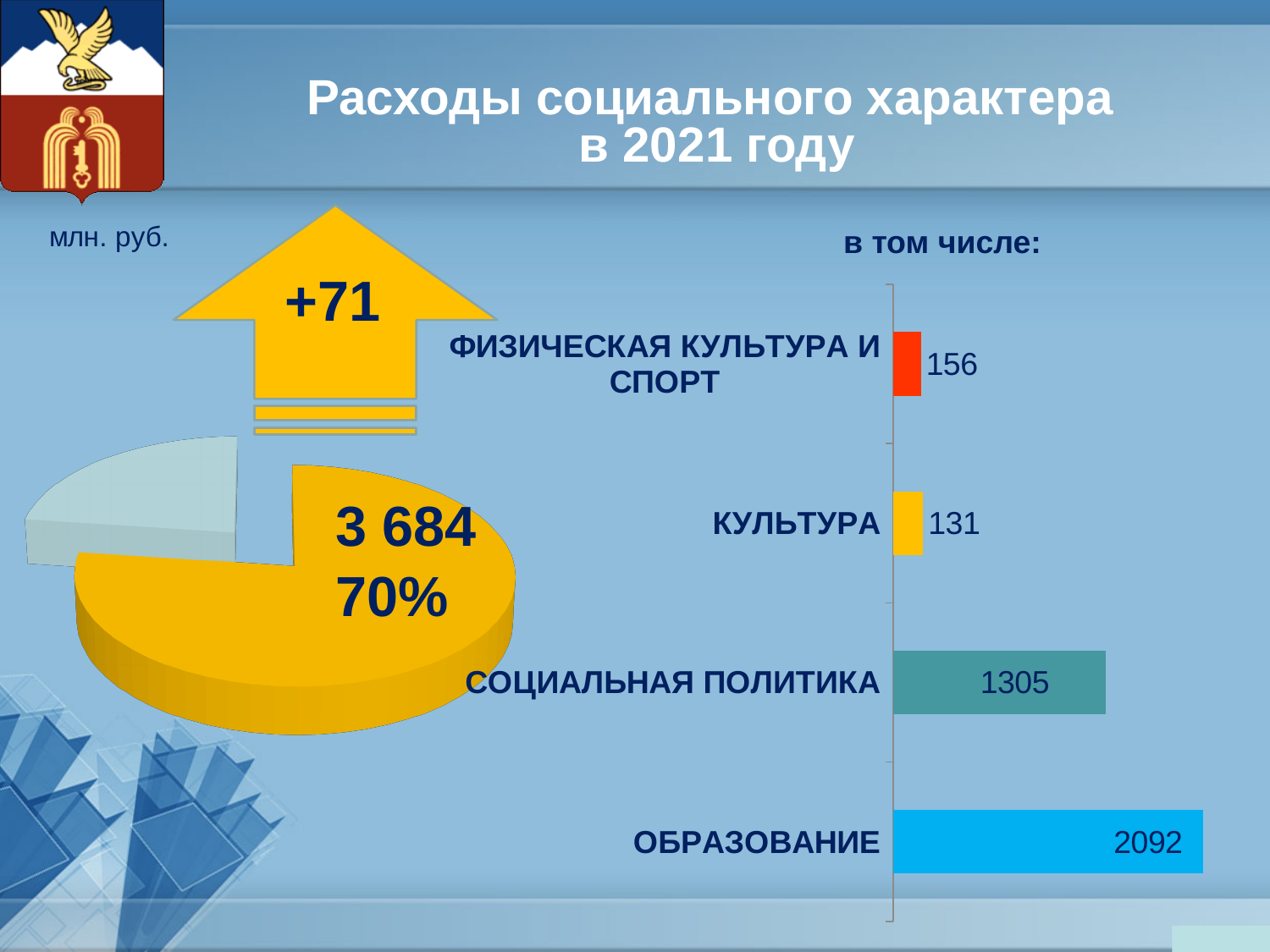
In the bar chart on the right, which is larger: ФИЗИЧЕСКАЯ КУЛЬТУРА И СПОРТ or КУЛЬТУРА? ФИЗИЧЕСКАЯ КУЛЬТУРА И СПОРТ In the bar chart on the right, which category has the lowest value? КУЛЬТУРА In the bar chart on the right, what is the value for ФИЗИЧЕСКАЯ КУЛЬТУРА И СПОРТ? 156 What kind of chart is shown on the left side of the slide? pie chart What kind of chart is shown on the right side of the slide? bar chart In the bar chart on the right, which category has the highest value? ОБРАЗОВАНИЕ In the bar chart on the right, what is the value for КУЛЬТУРА? 131 In the bar chart on the right, what is the difference between ОБРАЗОВАНИЕ and СОЦИАЛЬНАЯ ПОЛИТИКА? 787 In the bar chart on the right, what is the value for СОЦИАЛЬНАЯ ПОЛИТИКА? 1305 In the pie chart on the left, what share does the labelled yellow slice represent? 70% How many categories does the bar chart on the right show? 4 In the bar chart on the right, what is the value for ОБРАЗОВАНИЕ? 2092